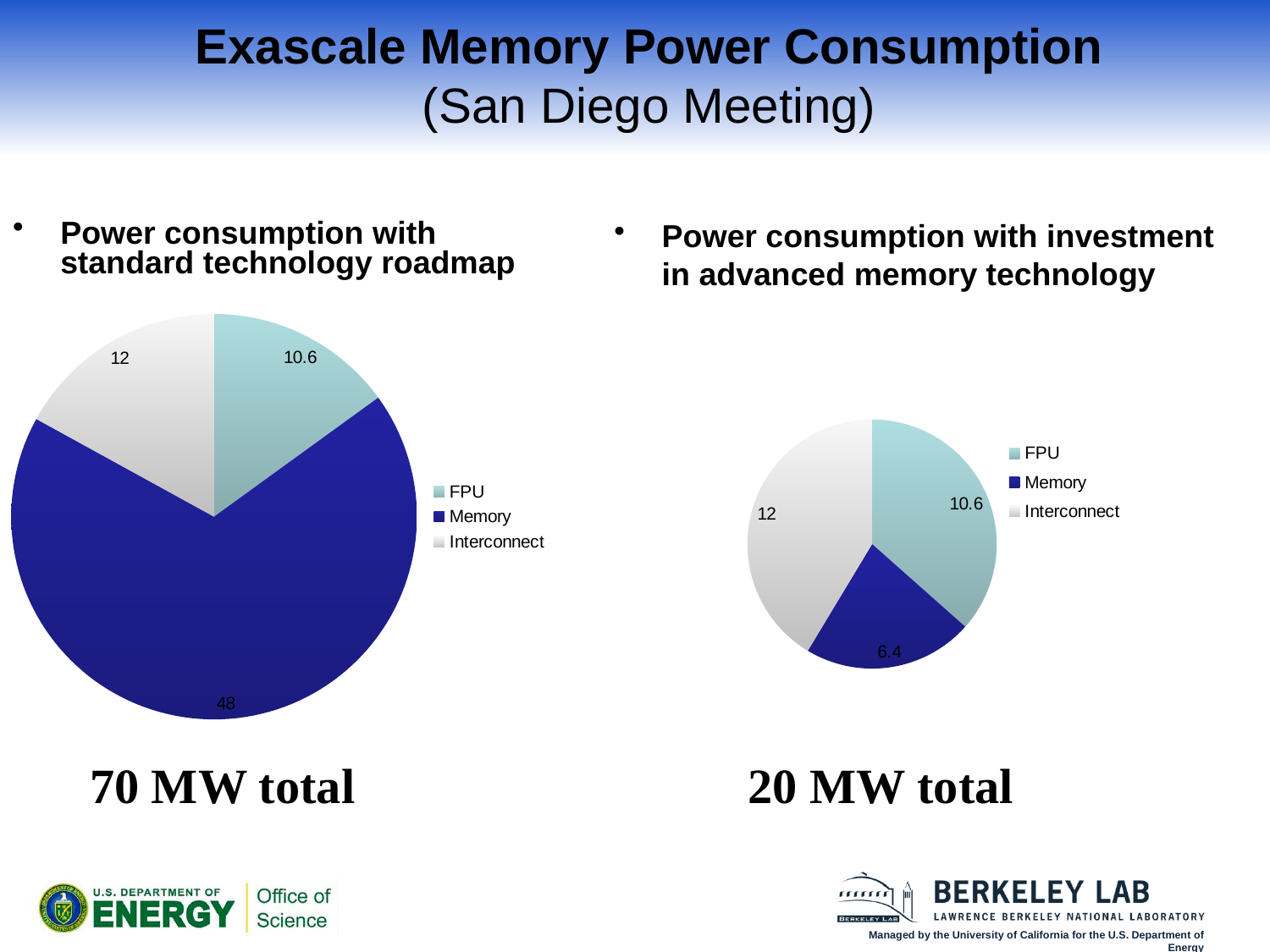
Which colour represents Memory in the pie charts? Dark blue What type of chart is used on the left side of the slide for the standard technology roadmap? Pie chart In the right pie chart (advanced memory technology), what is the difference between the Interconnect value and the Memory value? 5.6 In the left pie chart (standard technology roadmap), which category has the largest slice? Memory In the left pie chart (standard technology roadmap), what is the value for FPU? 10.6 How many categories does the legend of the left pie chart list? 3 In the right pie chart (advanced memory technology), which category has the smallest slice? Memory In the left pie chart (standard technology roadmap), what is the value for Memory? 48 In the right pie chart (advanced memory technology), what is the value for Interconnect? 12 In the left pie chart (standard technology roadmap), what is the difference between the Memory value and the Interconnect value? 36 In the right pie chart (advanced memory technology), what is the value for Memory? 6.4 In the right pie chart (advanced memory technology), which is larger, FPU or Memory? FPU